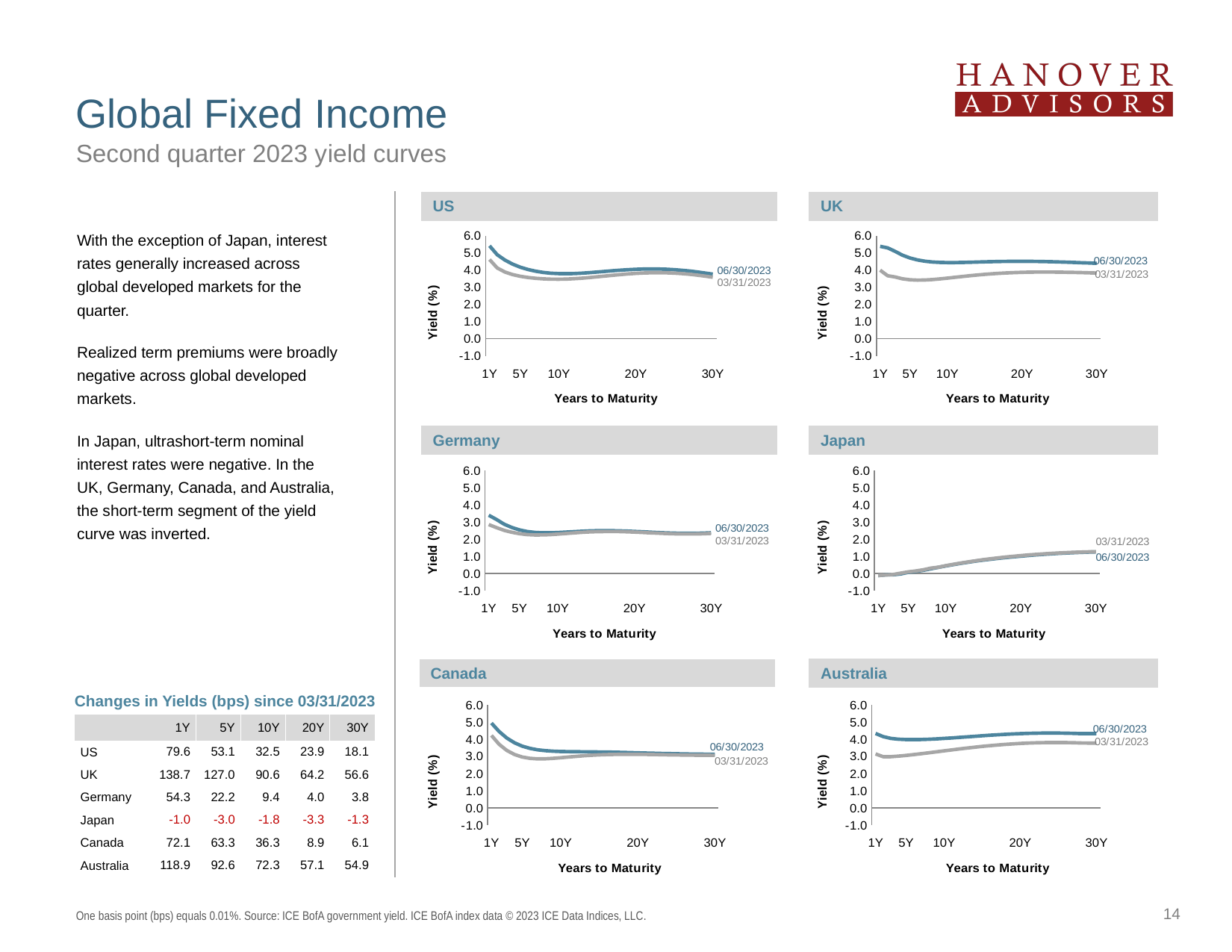
In the Australia chart, is the 03/31/2023 yield at 1Y greater or less than 4.0? less What kind of chart is the US chart? line chart In the Canada chart, does the 06/30/2023 yield rise or fall from 1Y to 10Y? fall In the Canada chart, is the 06/30/2023 yield at 1Y greater or less than 4.0? greater In the UK chart, is the 03/31/2023 yield at 5Y greater or less than 4.0? less In the UK chart, which series has the higher yield at 1Y, 06/30/2023 or 03/31/2023? 06/30/2023 What is the y-axis label on the Germany chart? Yield (%) How many series are plotted in the UK chart? 2 In the Japan chart, do yields rise or fall as years to maturity increase from 1Y to 30Y? rise